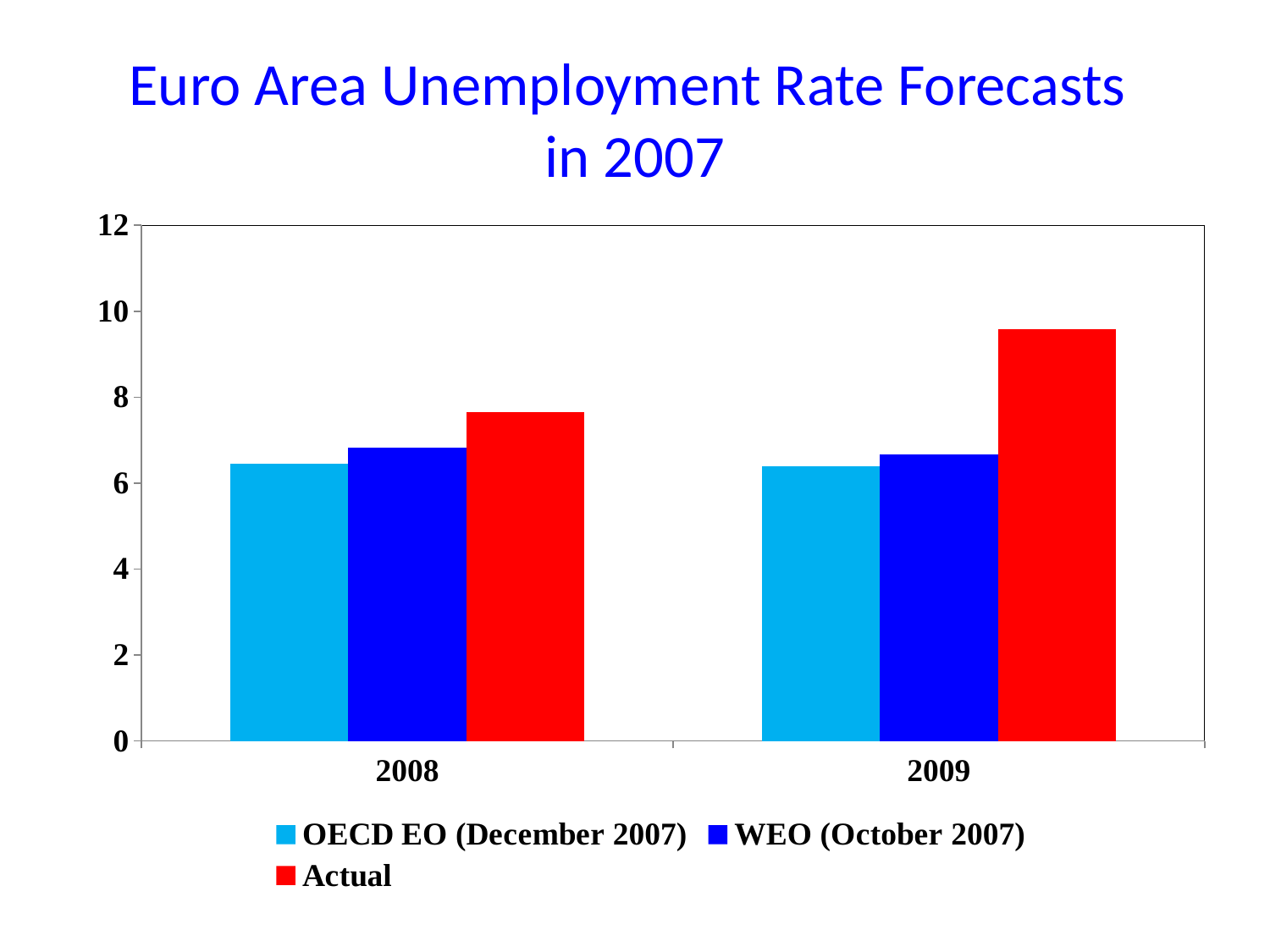
Is the WEO (October 2007) value for 2008 greater or less than 8? less Is the Actual value for 2009 greater or less than 8? greater What is the title of the chart on the slide? Euro Area Unemployment Rate Forecasts in 2007 Which series has the highest bar for 2009? Actual What kind of chart is shown on the slide? bar chart Is the OECD EO (December 2007) value for 2009 greater or less than 6? greater Which series has the lowest bar for 2008? OECD EO (December 2007) How many series does the legend list? 3 Which is larger: the Actual value for 2009 or the Actual value for 2008? Actual value for 2009 Which is larger for 2008: the WEO (October 2007) forecast or the Actual value? Actual Does the Actual series rise or fall from 2008 to 2009? rise How many year categories are shown on the x axis? 2